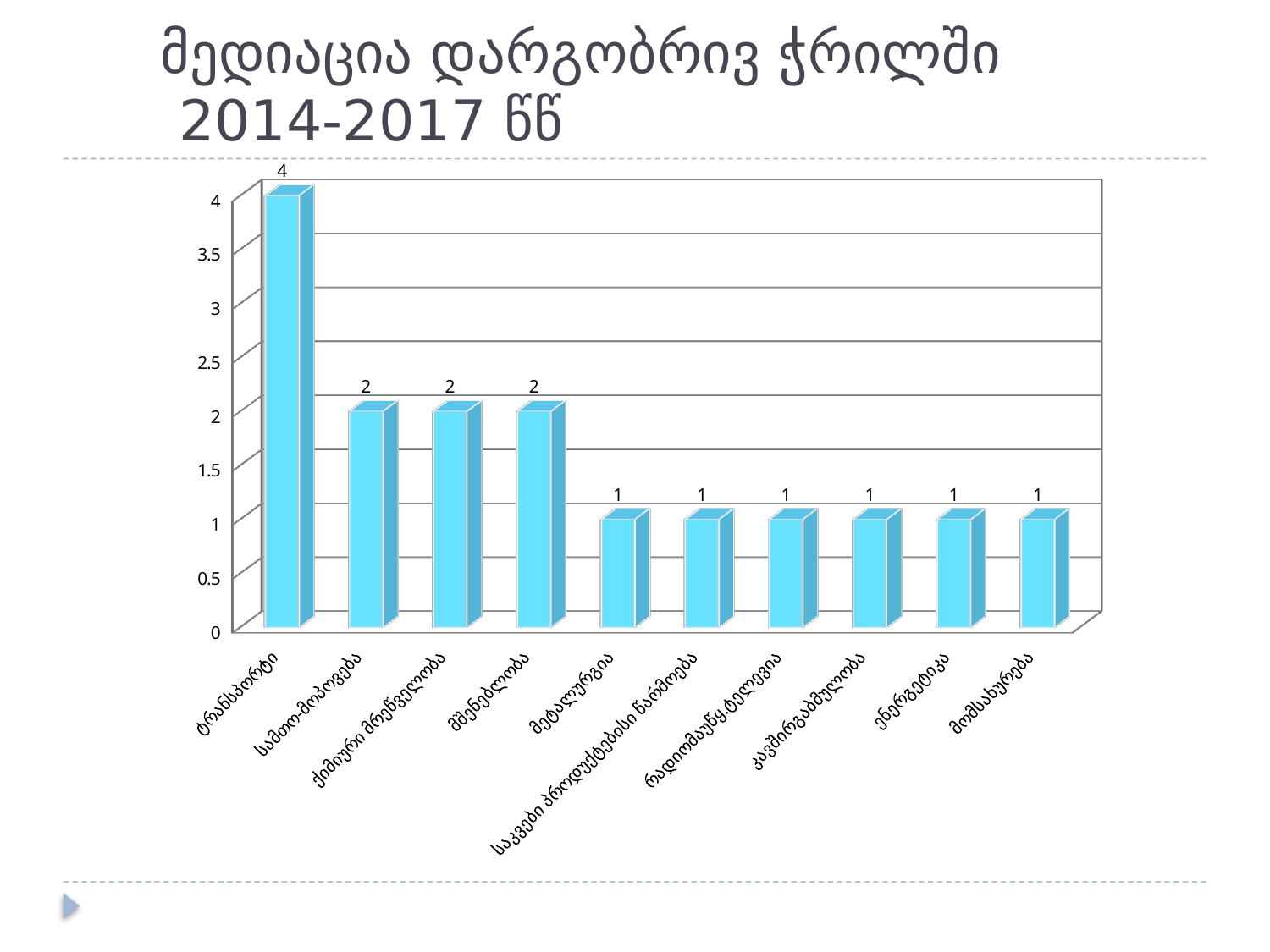
Which is larger, the value for ქიმიური მრეწველობა or the value for მეტალურგია? ქიმიური მრეწველობა How many categories are shown on the x axis? 10 What is the value for ენერგეტიკა? 1 How many categories have a value of 2? 3 Do the values rise or fall moving from left to right along the x axis? Fall How many categories have a value of 1? 6 What is the value for მშენებლობა? 2 What type of chart is shown on the slide? Bar chart What is the difference between the values for ტრანსპორტი and სამთო-მოპოვება? 2 What is the value for ტრანსპორტი? 4 What is the title of the chart on the slide? მედიაცია დარგობრივ ჭრილში 2014-2017 წწ Which category has the highest value? ტრანსპორტი